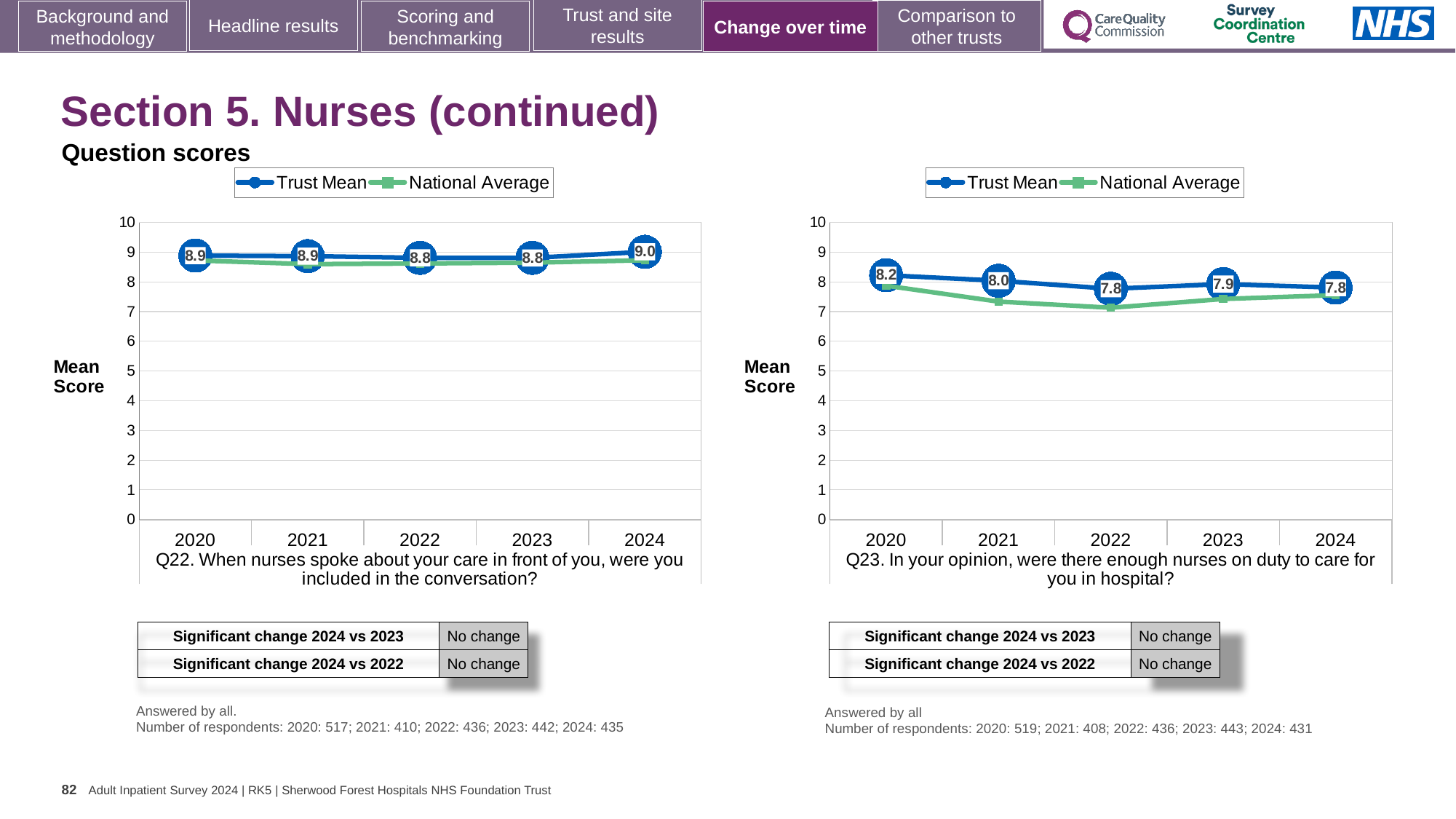
In the Q23 chart on the right, which year has the highest Trust Mean score? 2020 In the Q22 chart on the left, which year has the highest Trust Mean score? 2024 How many years are plotted on the x axis of the Q22 chart on the left? 5 How many series does the legend of the Q23 chart on the right list? 2 In the Q23 chart on the right, what is the Trust Mean score for 2020? 8.2 In the Q23 chart on the right, what is the Trust Mean score for 2022? 7.8 In the Q22 chart on the left, what is the Trust Mean score for 2024? 9.0 In the Q23 chart on the right, is the National Average value for 2022 greater or less than 8? less In the Q23 chart on the right, which year has the larger Trust Mean score, 2020 or 2021? 2020 In the Q23 chart on the right, does the Trust Mean score rise or fall overall from 2020 to 2024? Fall In the Q23 chart on the right, what is the difference between the Trust Mean scores for 2020 and 2022? 0.4 What kind of chart is the Q22 chart on the left? Line chart